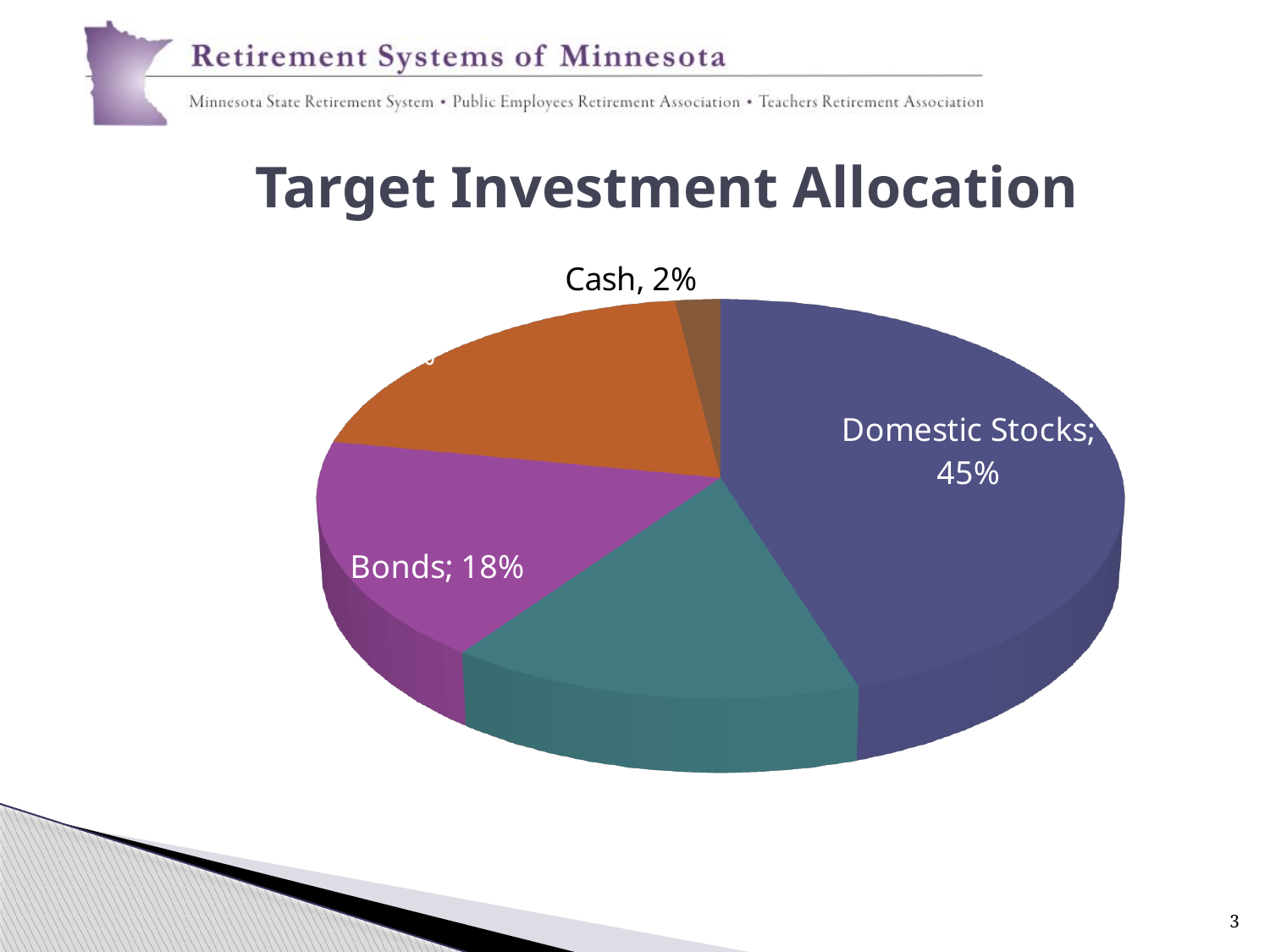
What colour is the Domestic Stocks slice? Blue How many slices does the pie chart have? 5 Which category has the smallest share of the pie? Cash How many percentage points larger is the Domestic Stocks share than the Bonds share? 27% What is the title of the chart? Target Investment Allocation Which category has the largest share of the pie? Domestic Stocks What percentage of the target investment allocation is Bonds? 18% What type of chart is shown on the slide? Pie chart What percentage of the target investment allocation is Cash? 2% What is the combined share of Bonds and Cash? 20% Which is larger, the share for Bonds or the share for Cash? Bonds What percentage of the target investment allocation is Domestic Stocks? 45%